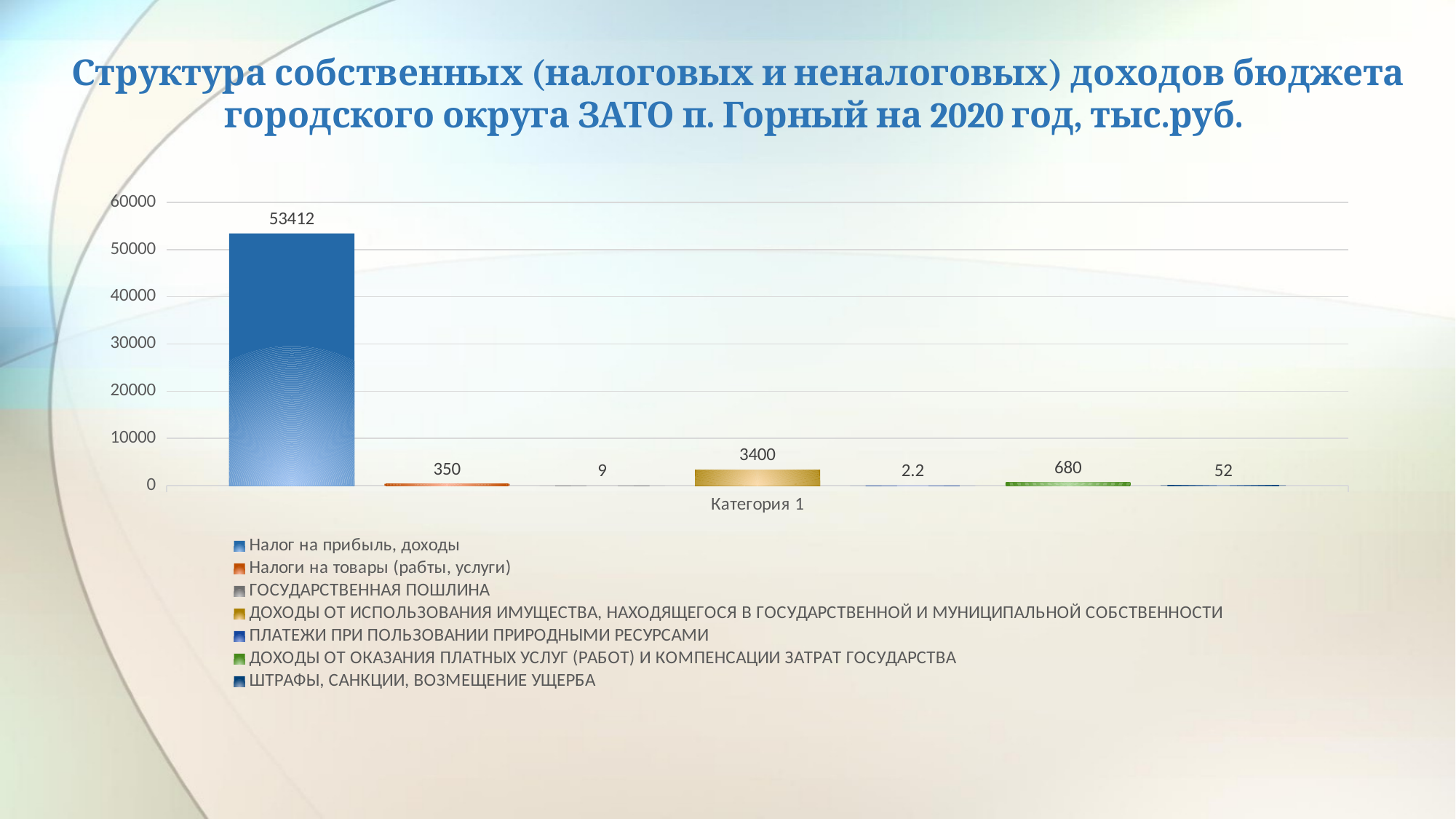
What is the difference between the value for ДОХОДЫ ОТ ОКАЗАНИЯ ПЛАТНЫХ УСЛУГ (РАБОТ) И КОМПЕНСАЦИИ ЗАТРАТ ГОСУДАРСТВА and the value for Налоги на товары (рабты, услуги)? 330 What is the label on the x axis under the bars? Категория 1 Which series has the highest value? Налог на прибыль, доходы What is the value for ДОХОДЫ ОТ ИСПОЛЬЗОВАНИЯ ИМУЩЕСТВА, НАХОДЯЩЕГОСЯ В ГОСУДАРСТВЕННОЙ И МУНИЦИПАЛЬНОЙ СОБСТВЕННОСТИ? 3400 Which series has the lowest value? ПЛАТЕЖИ ПРИ ПОЛЬЗОВАНИИ ПРИРОДНЫМИ РЕСУРСАМИ What is the value for ПЛАТЕЖИ ПРИ ПОЛЬЗОВАНИИ ПРИРОДНЫМИ РЕСУРСАМИ? 2.2 Which is larger: the value for ГОСУДАРСТВЕННАЯ ПОШЛИНА or the value for ШТРАФЫ, САНКЦИИ, ВОЗМЕЩЕНИЕ УЩЕРБА? ШТРАФЫ, САНКЦИИ, ВОЗМЕЩЕНИЕ УЩЕРБА How many series does the legend list? 7 What is the value for Налоги на товары (рабты, услуги)? 350 What is the value for ШТРАФЫ, САНКЦИИ, ВОЗМЕЩЕНИЕ УЩЕРБА? 52 What type of chart is shown on the slide? bar chart What is the value for Налог на прибыль, доходы? 53412